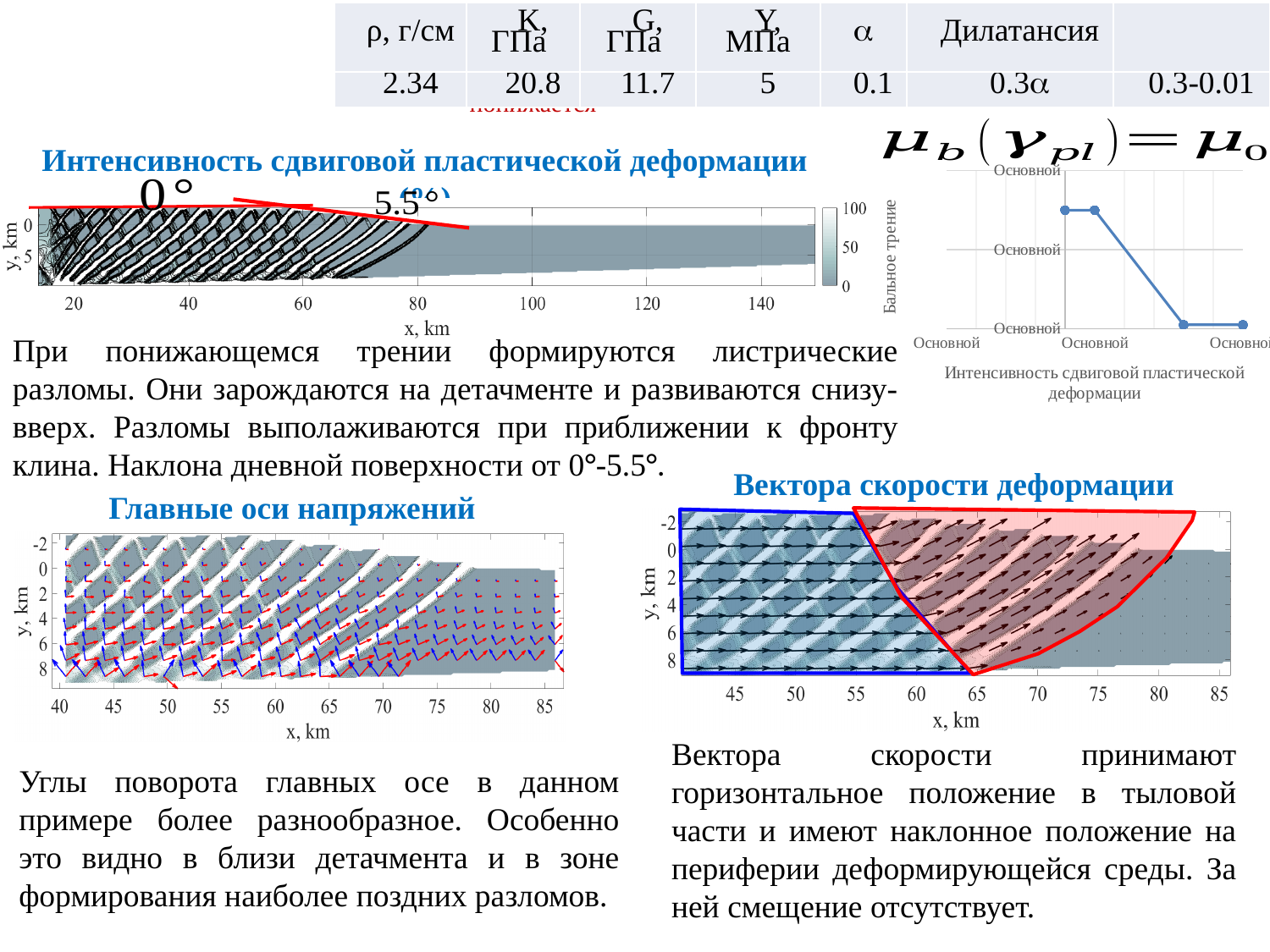
On the line chart on the right, which is larger: the first point or the last point? the first point What colour is the line on the line chart on the right side of the slide? blue On the line chart on the right, are the last two points at the same level or at different levels? the same level What is the x-axis title of the line chart on the right side of the slide? Интенсивность сдвиговой пластической деформации On the line chart on the right, are the first two points at the same level or at different levels? the same level On the line chart on the right, do the values rise or fall as you move along the x axis from left to right? fall What kind of chart is the chart on the right with the x-axis title 'Интенсивность сдвиговой пластической деформации'? line chart How many data points are plotted on the line chart on the right side of the slide? 4